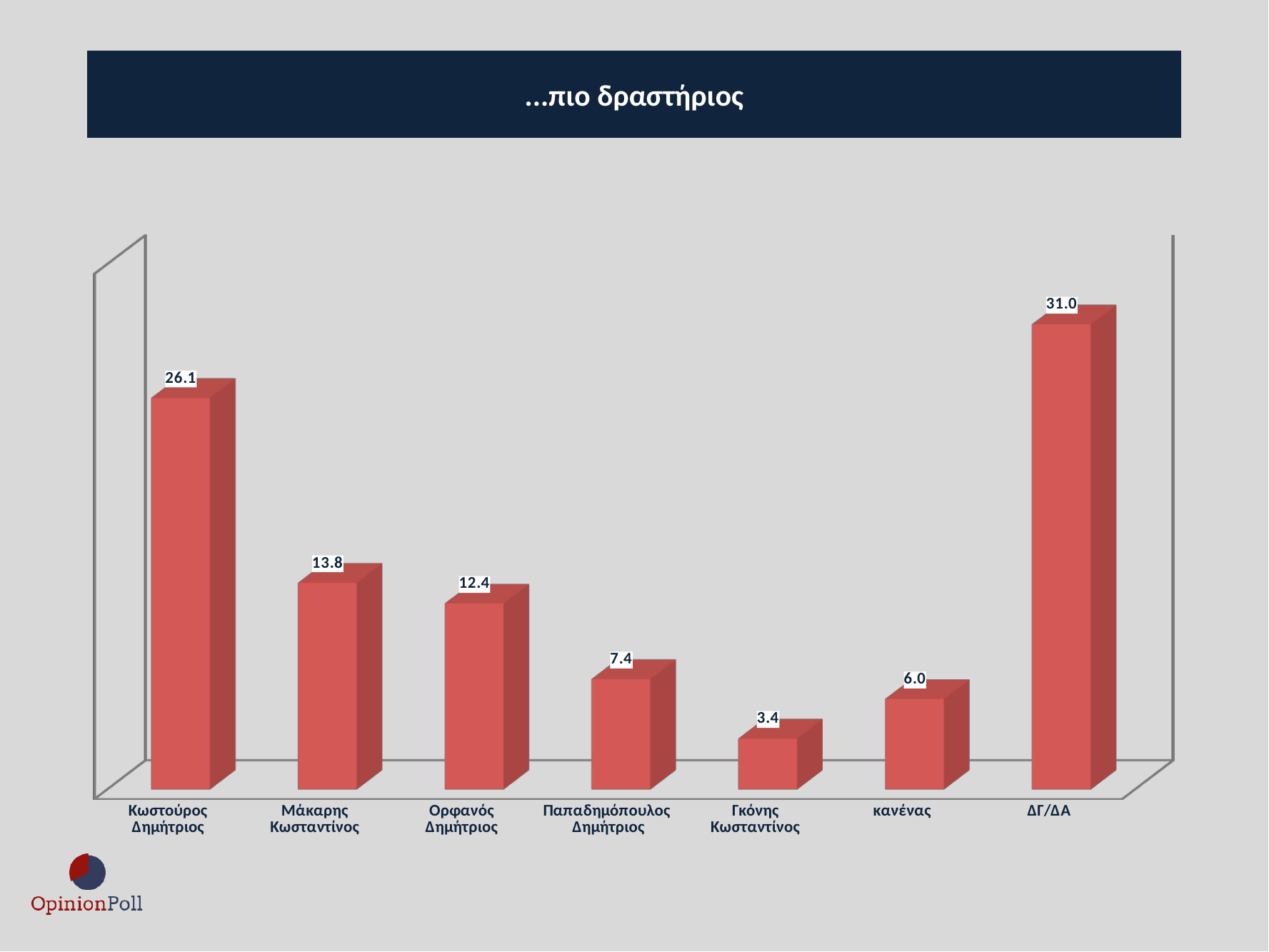
What is the value for Ορφανός Δημήτριος? 12.4 What is the value for Μάκαρης Κωσταντίνος? 13.8 Which is larger, the value for κανένας or the value for Παπαδημόπουλος Δημήτριος? Παπαδημόπουλος Δημήτριος What is the value for Γκόνης Κωσταντίνος? 3.4 What is the value for ΔΓ/ΔΑ? 31.0 What is the value for Παπαδημόπουλος Δημήτριος? 7.4 What is the value for Κωστούρος Δημήτριος? 26.1 Which category has the lowest value? Γκόνης Κωσταντίνος What is the difference between the values for ΔΓ/ΔΑ and Κωστούρος Δημήτριος? 4.9 Which category has the highest value? ΔΓ/ΔΑ What kind of chart is shown on the slide? Bar chart How many categories are shown on the chart? 7